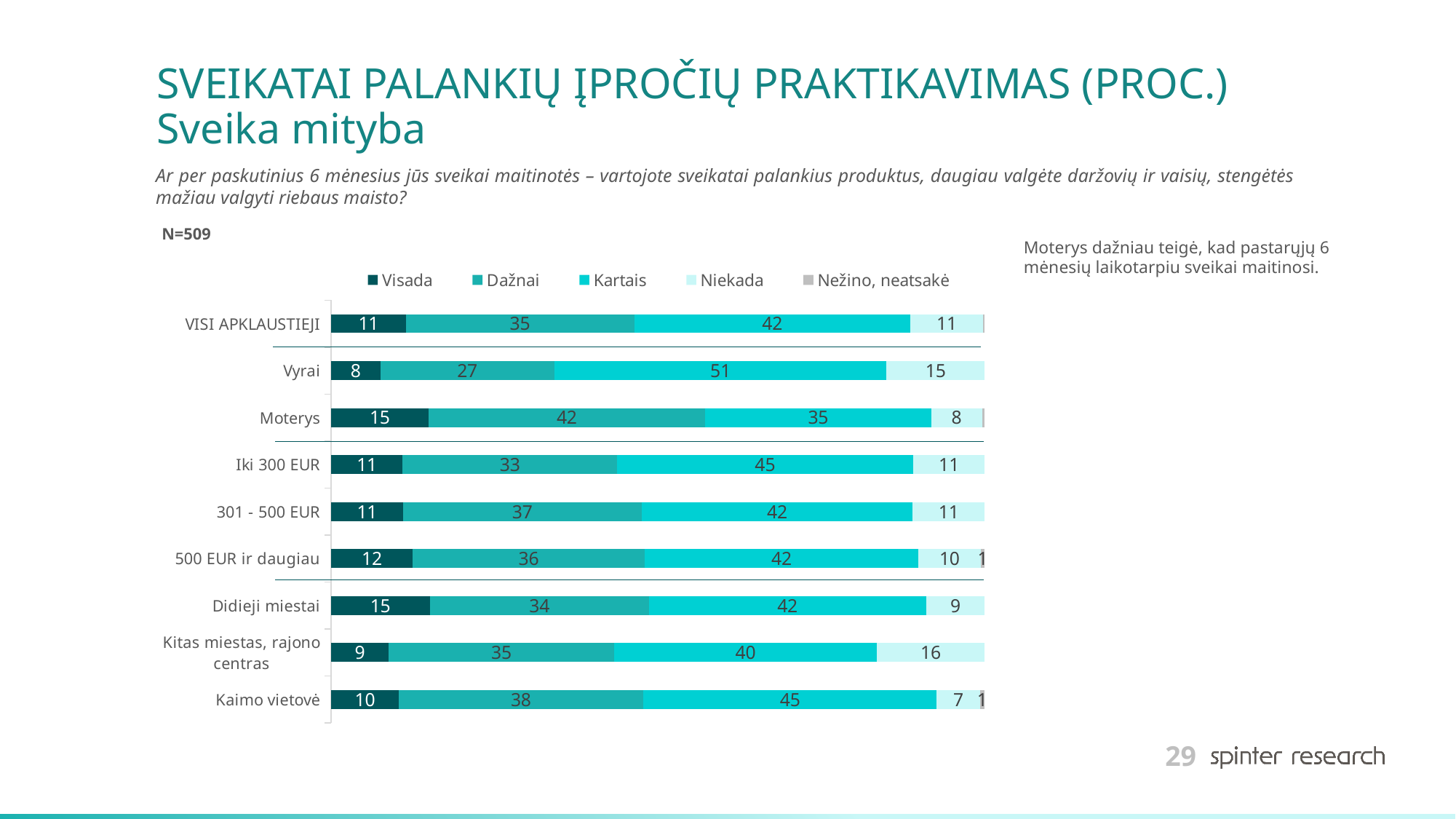
What sample size (N) is stated on the slide? N=509 Which has a larger Visada value, Didieji miestai or Kaimo vietovė? Didieji miestai What is the difference between the Dažnai values for Moterys and Vyrai? 15 Which category has the highest value for Kartais? Vyrai What is the value for Nežino, neatsakė in the Kaimo vietovė bar? 1 What kind of chart is shown on the slide? Stacked bar chart Which category has the lowest value for Niekada? Kaimo vietovė What is the value for Niekada in the Kitas miestas, rajono centras bar? 16 What is the value for Kartais in the Vyrai bar? 51 How many series does the legend list? 5 How many categories are shown on the chart? 9 What is the value for Visada in the Moterys bar? 15